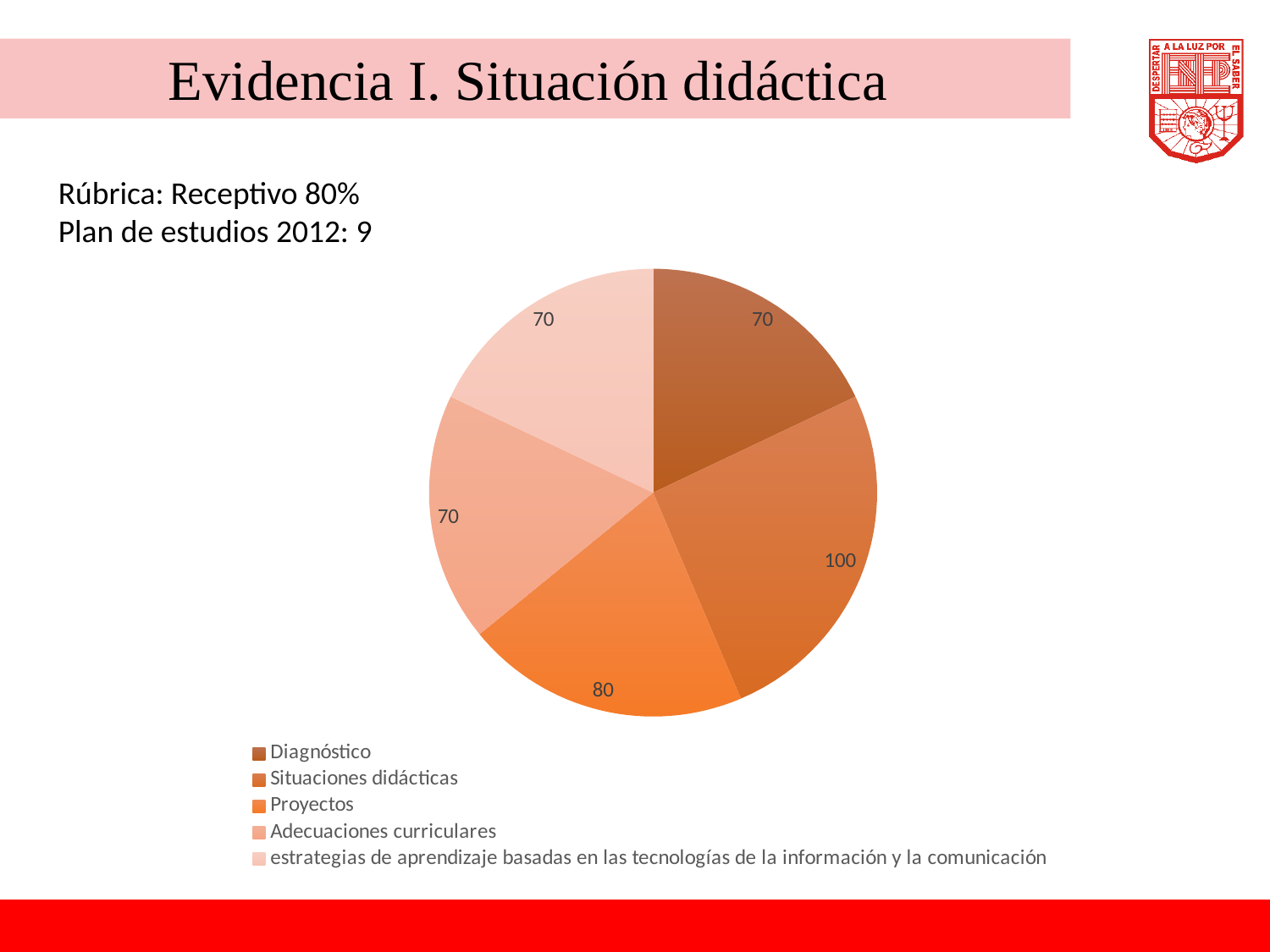
What is the difference between the values for Situaciones didácticas and Proyectos? 20 What is the total of all the slice values in the pie chart? 390 How many slices does the pie chart have? 5 Which category has the largest slice in the pie chart? Situaciones didácticas What is the difference between the values for Proyectos and Diagnóstico? 10 How many entries does the legend list? 5 What is the value for Proyectos? 80 What is the value for Diagnóstico? 70 Which is larger, the value for Proyectos or the value for Adecuaciones curriculares? Proyectos What is the value for Adecuaciones curriculares? 70 What is the value for Situaciones didácticas? 100 What type of chart is shown on the slide? Pie chart